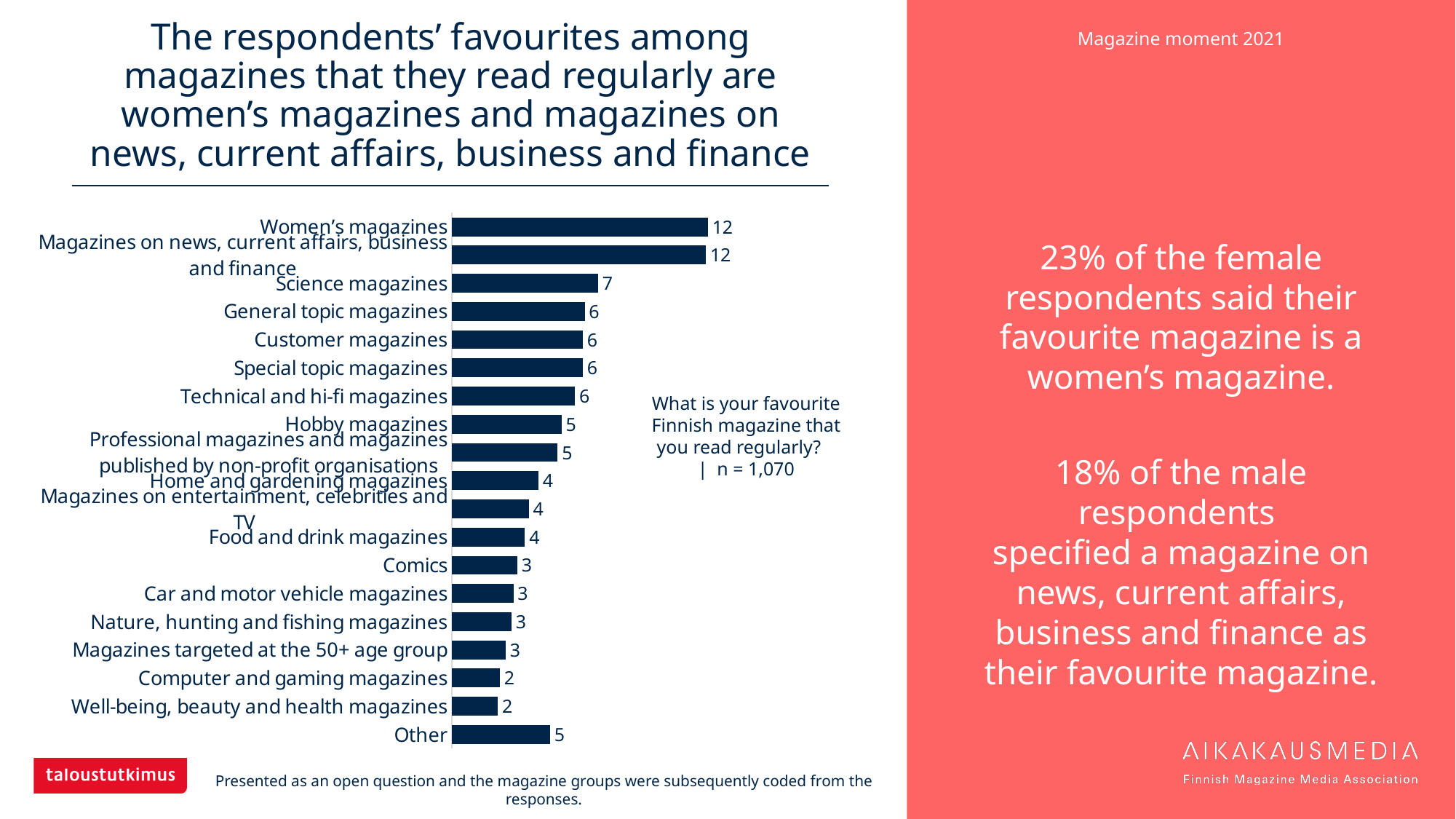
How many categories are shown in the chart? 19 What value is shown for Women's magazines? 12 What is the sample size (n) stated next to the chart? n = 1,070 What value is shown for Science magazines? 7 What is the difference between the values for Women's magazines and Science magazines? 5 What kind of chart is shown on the slide? Bar chart Which has a larger value, Customer magazines or Comics? Customer magazines Which has a larger value, Science magazines or Food and drink magazines? Science magazines What value is shown for Comics? 3 What value is shown for the Other category? 5 What is the difference between the values for Hobby magazines and Computer and gaming magazines? 3 What value is shown for Well-being, beauty and health magazines? 2